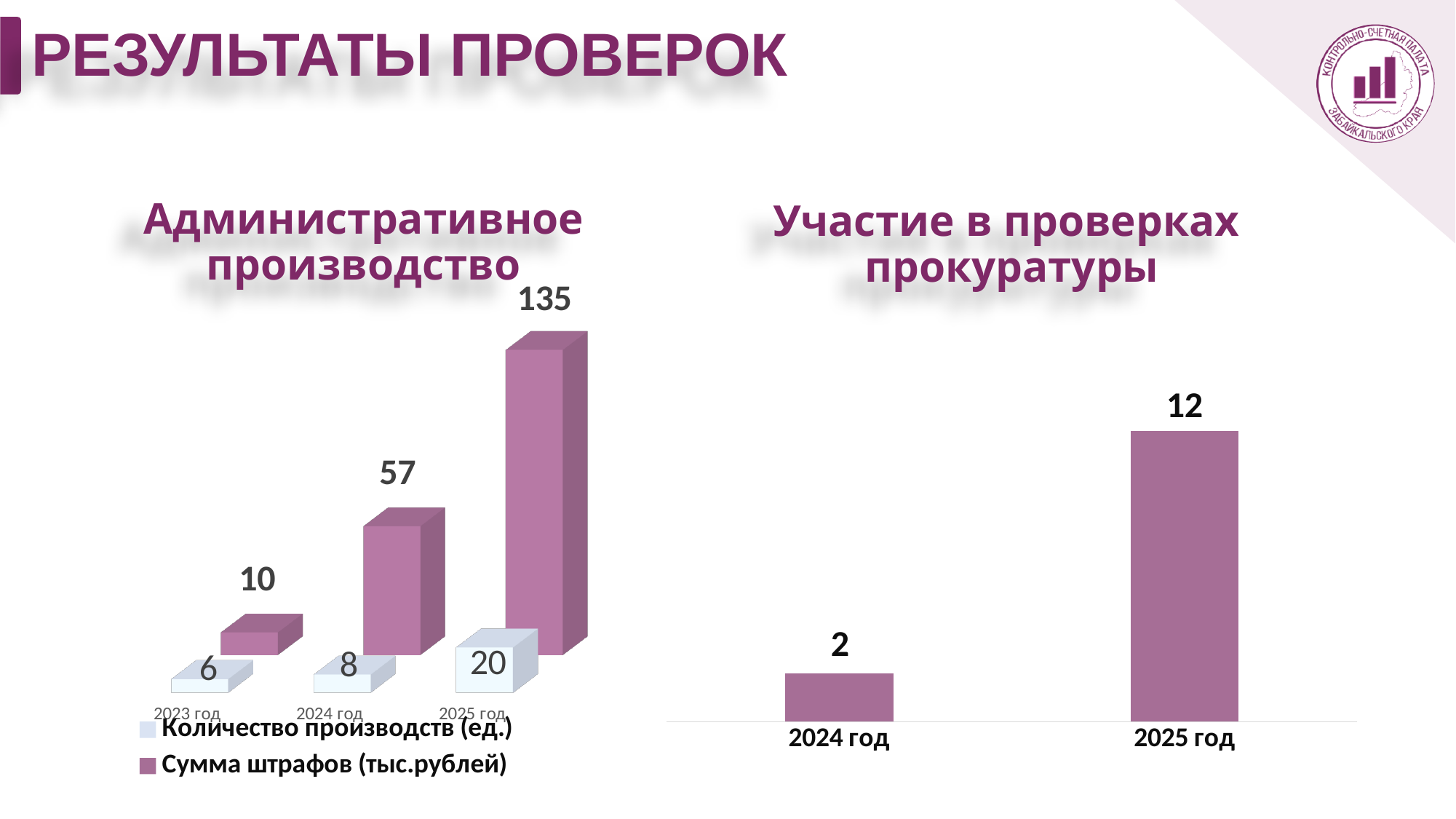
In the 'Участие в проверках прокуратуры' chart, how many categories are shown on the x axis? 2 In the 'Административное производство' chart, how many series does the legend list? 2 In the 'Административное производство' chart, what is the value of 'Количество производств (ед.)' for 2023 год? 6 In the 'Административное производство' chart, what is the value of 'Сумма штрафов (тыс.рублей)' for 2025 год? 135 In the 'Участие в проверках прокуратуры' chart, what is the value for 2025 год? 12 In the 'Административное производство' chart, does 'Сумма штрафов (тыс.рублей)' rise or fall from 2023 год to 2025 год? rise In the 'Административное производство' chart, which year has the highest 'Сумма штрафов (тыс.рублей)'? 2025 год In the 'Административное производство' chart, what is the difference between 'Сумма штрафов (тыс.рублей)' in 2025 год and 2024 год? 78 In the 'Участие в проверках прокуратуры' chart, what is the difference between the values for 2025 год and 2024 год? 10 What kind of chart is the 'Участие в проверках прокуратуры' chart? bar chart In the 'Административное производство' chart, which year has the lowest 'Количество производств (ед.)'? 2023 год In the 'Административное производство' chart, what is the value of 'Сумма штрафов (тыс.рублей)' for 2024 год? 57